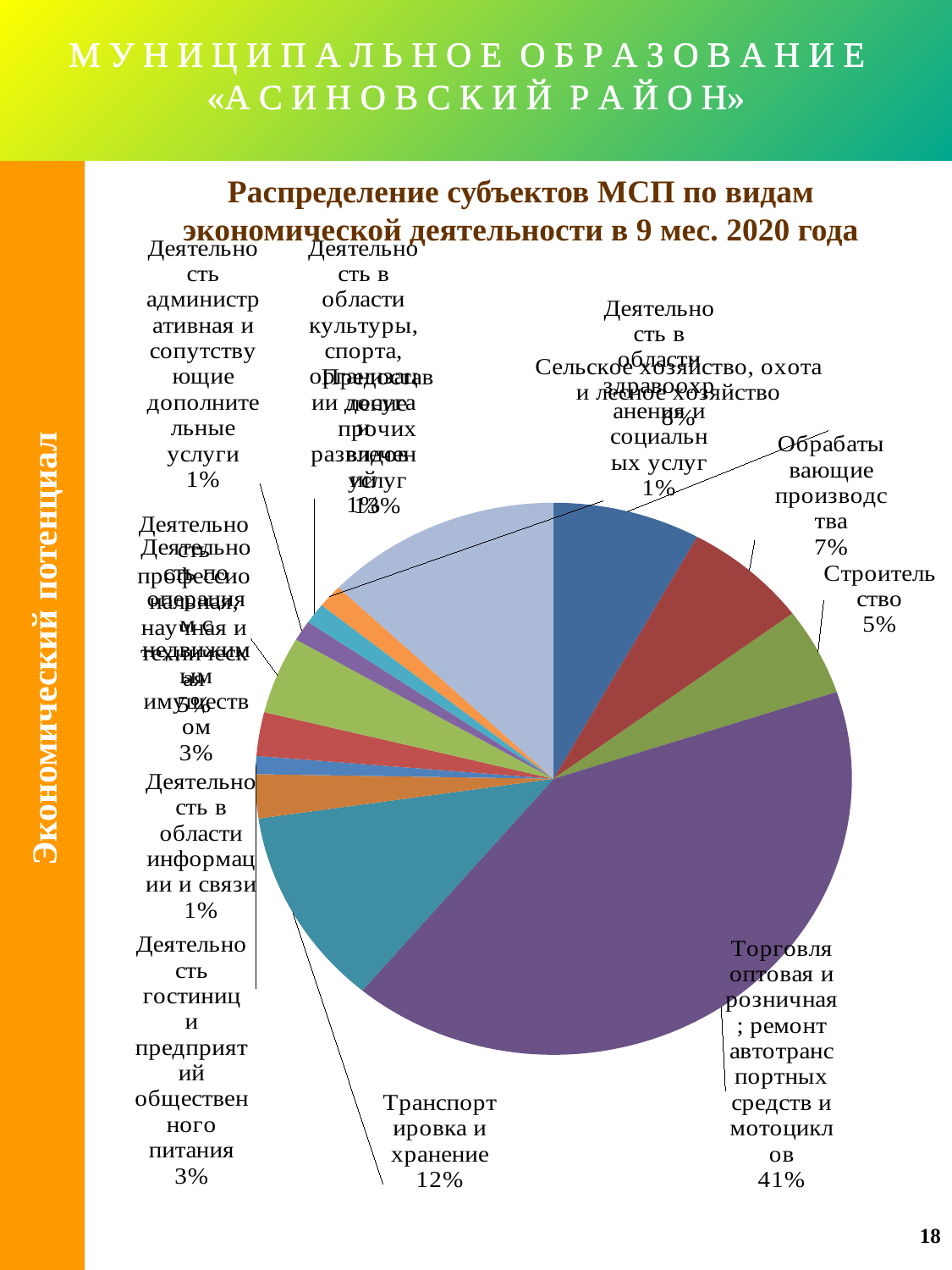
What share is shown for "Строительство"? 5% What share is shown for "Транспортировка и хранение"? 12% What is the difference in percentage points between the share for "Торговля оптовая и розничная; ремонт автотранспортных средств и мотоциклов" and the share for "Транспортировка и хранение"? 29 percentage points What share of the pie does "Торговля оптовая и розничная; ремонт автотранспортных средств и мотоциклов" have? 41% What share is shown for "Обрабатывающие производства"? 7% Which category has the largest share of the pie? Торговля оптовая и розничная; ремонт автотранспортных средств и мотоциклов What share is shown for "Деятельность в области информации и связи"? 1% What share is shown for "Сельское хозяйство, охота и лесное хозяйство"? 8% Which is larger: the share for "Транспортировка и хранение" or for "Обрабатывающие производства"? Транспортировка и хранение What kind of chart is shown on the slide? pie chart What is the title of the chart? Распределение субъектов МСП по видам экономической деятельности в 9 мес. 2020 года What share is shown for "Деятельность гостиниц и предприятий общественного питания"? 3%